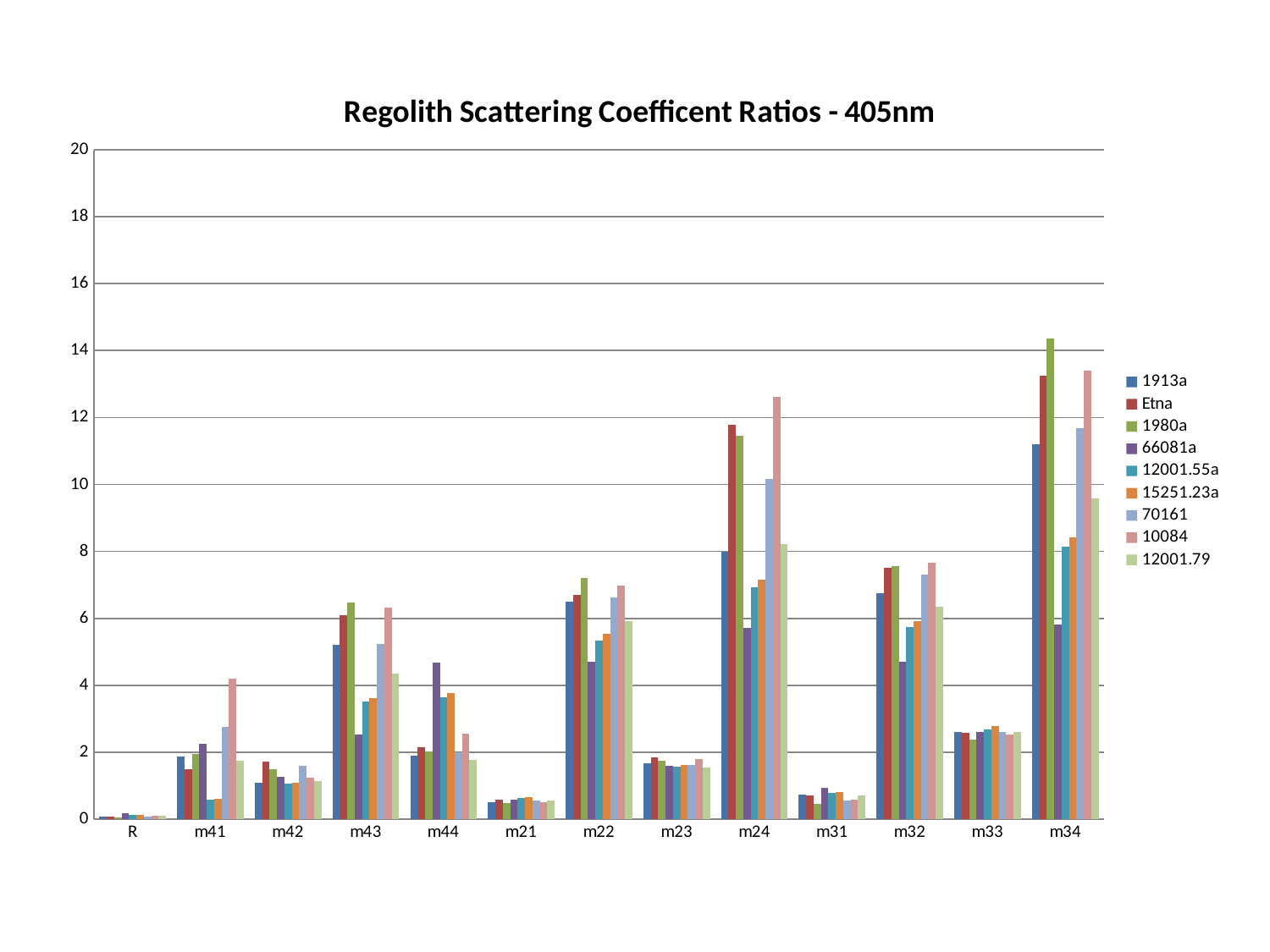
At m44, which is larger: the 66081a value or the 1913a value? 66081a What kind of chart is shown on the slide? bar chart At m24, which is larger: the Etna value or the 1913a value? Etna Which category has the lowest value for the 10084 series? R Which category has the highest value for the 1980a series? m34 What is the title of the chart? Regolith Scattering Coefficent Ratios - 405nm Is the value for 1980a at m34 greater or less than 12? greater Is the value for 70161 at m43 greater or less than 4? greater How many categories are shown along the x axis? 13 Is the value for 1913a at m34 greater or less than 10? greater How many series does the legend list? 9